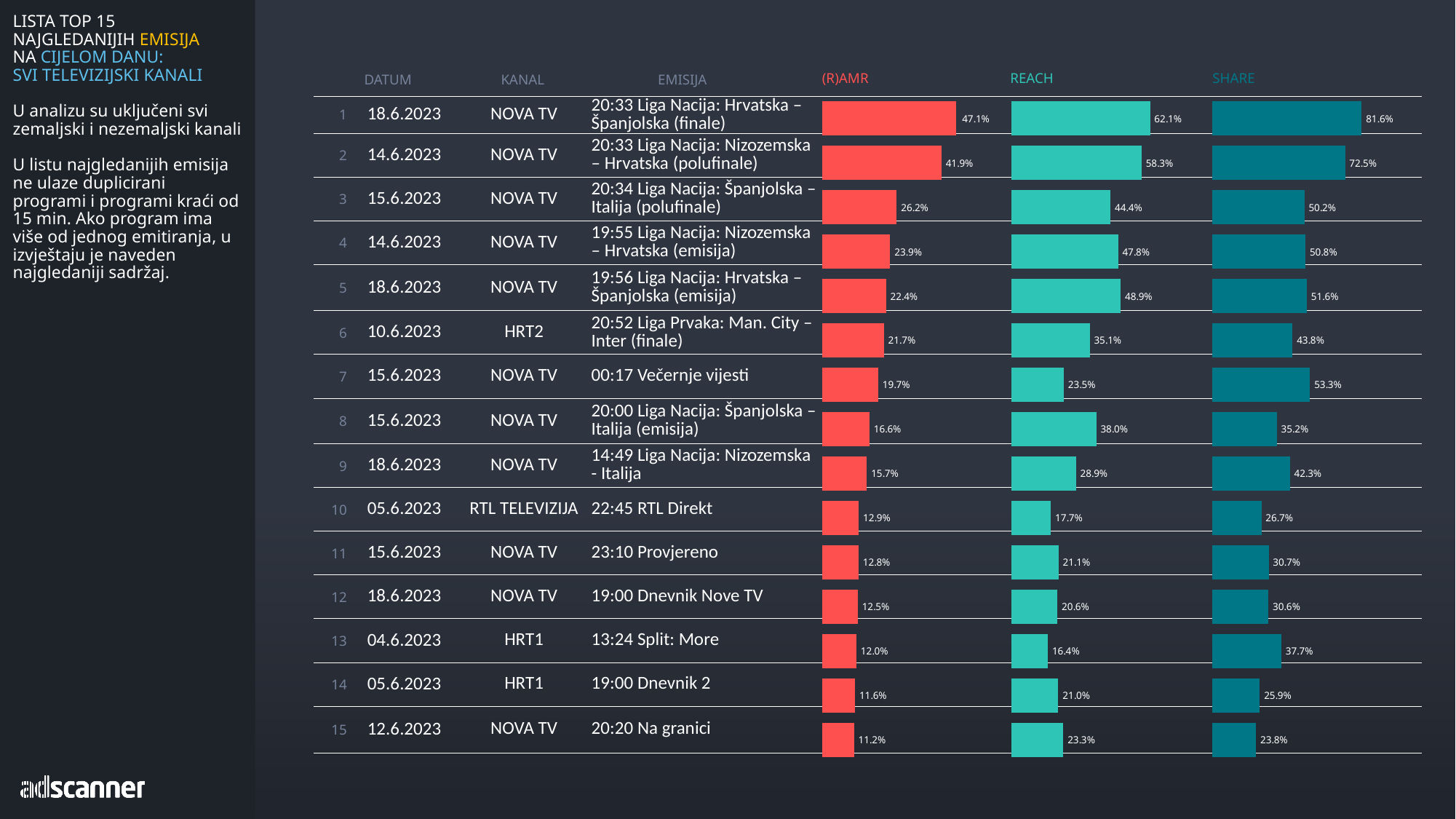
In the (R)AMR chart, what is the value for 20:33 Liga Nacija: Hrvatska – Španjolska (finale)? 47.1% In the REACH chart, which programme has the lowest value? 13:24 Split: More In the (R)AMR chart, what is the difference between 20:33 Liga Nacija: Hrvatska – Španjolska (finale) and 20:33 Liga Nacija: Nizozemska – Hrvatska (polufinale)? 5.2% In the SHARE chart, what is the value for 00:17 Večernje vijesti? 53.3% In the SHARE chart, which is larger: 13:24 Split: More or 22:45 RTL Direkt? 13:24 Split: More In the SHARE chart, which programme has the highest value? 20:33 Liga Nacija: Hrvatska – Španjolska (finale) How many programmes are listed in the (R)AMR chart? 15 What colour are the bars in the (R)AMR chart? Red In the REACH chart, which is larger: 19:55 Liga Nacija: Nizozemska – Hrvatska (emisija) or 20:34 Liga Nacija: Španjolska – Italija (polufinale)? 19:55 Liga Nacija: Nizozemska – Hrvatska (emisija) What kind of chart is used for the (R)AMR, REACH and SHARE columns? Bar chart In the REACH chart, what is the value for 20:52 Liga Prvaka: Man. City – Inter (finale)? 35.1% Do the (R)AMR values rise or fall going down the list from rank 1 to rank 15? Fall